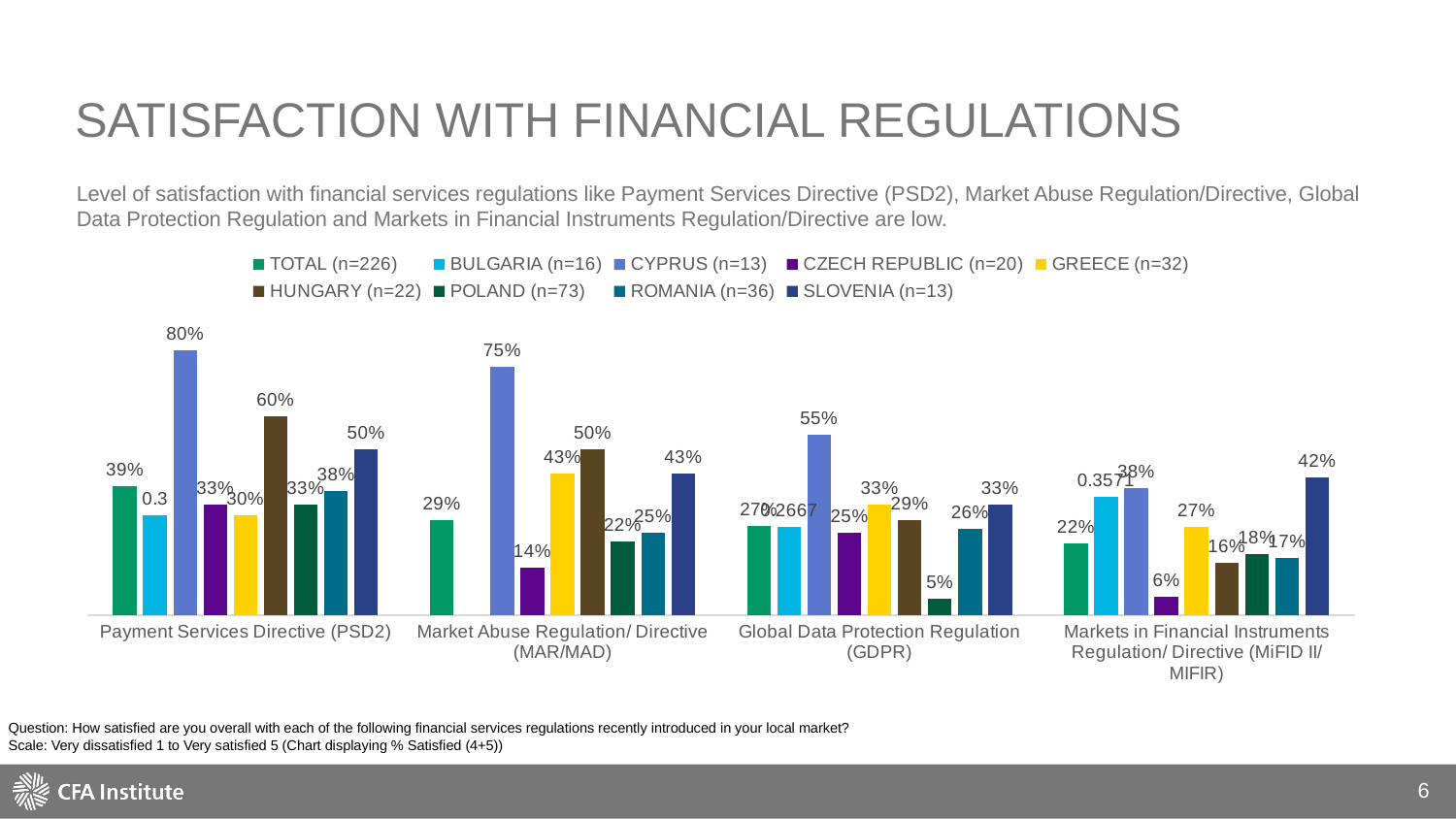
How many regulation categories are shown on the x axis? 4 What is the value for HUNGARY in the Payment Services Directive (PSD2) category? 60% How many series does the legend list? 9 What is the value for CYPRUS in the Payment Services Directive (PSD2) category? 80% In the Markets in Financial Instruments Regulation/ Directive (MiFID II/ MIFIR) category, which is larger: SLOVENIA or CYPRUS? SLOVENIA What is the TOTAL value for Market Abuse Regulation/ Directive (MAR/MAD)? 29% What is the value for CZECH REPUBLIC in the Markets in Financial Instruments Regulation/ Directive (MiFID II/ MIFIR) category? 6% Which country has the highest value in the Market Abuse Regulation/ Directive (MAR/MAD) category? CYPRUS Do the TOTAL values rise or fall moving from Payment Services Directive (PSD2) to Markets in Financial Instruments Regulation/ Directive (MiFID II/ MIFIR)? Fall Which country has the lowest value in the Global Data Protection Regulation (GDPR) category? POLAND What kind of chart is shown on the slide? Bar chart What is the difference between the CYPRUS and HUNGARY values for Payment Services Directive (PSD2)? 20 percentage points